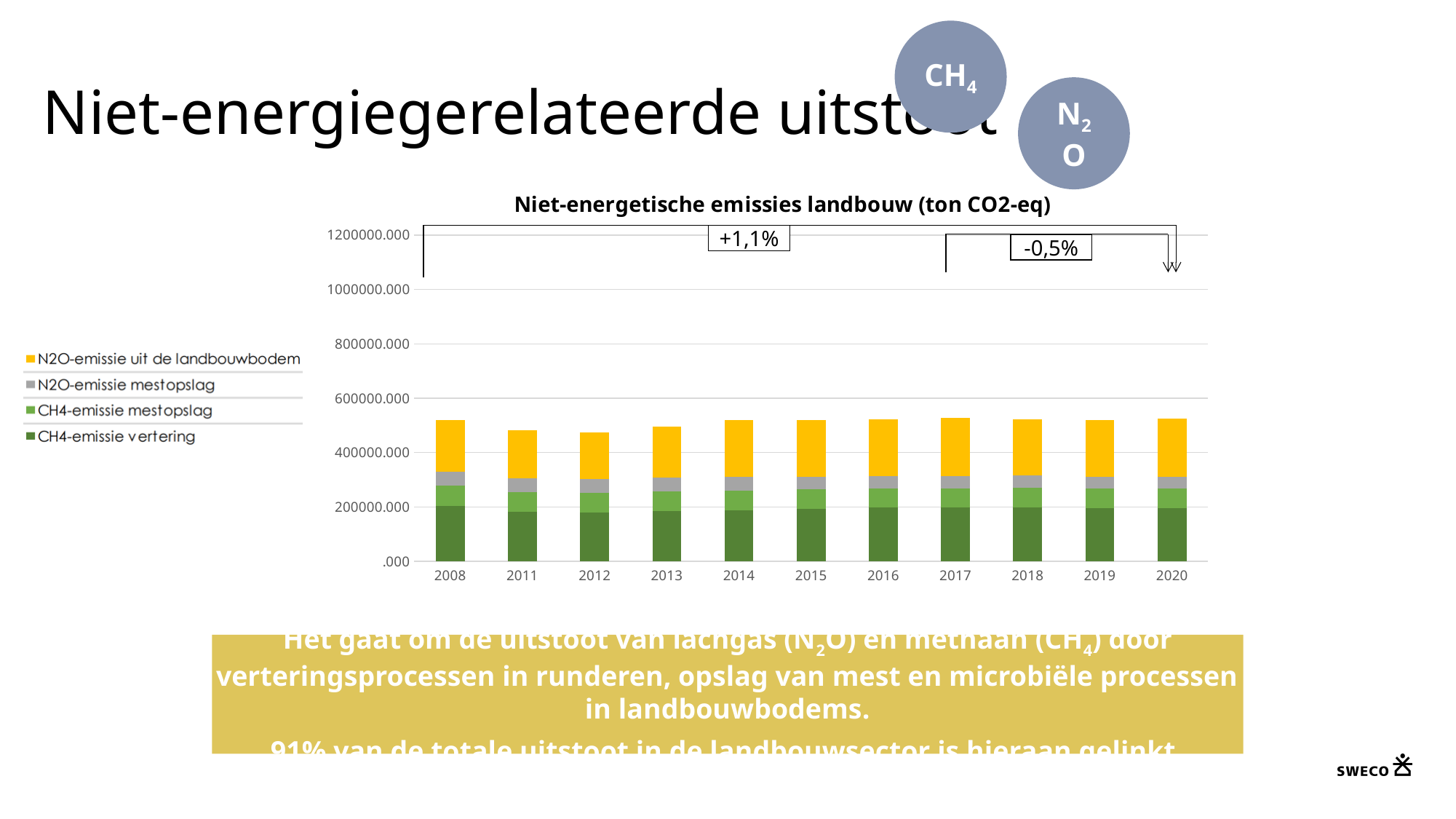
Which series is shown at the bottom of each stacked bar? CH4-emissie vertering Is the total stacked value for 2020 greater or less than 600000.000? less Do the total stacked values rise or fall from 2012 to 2014? rise Is the total stacked value for 2008 greater or less than 400000.000? greater What percentage change is shown in the annotation box on the right side of the chart? -0,5% How many series does the legend list? 4 What is the title of the chart? Niet-energetische emissies landbouw (ton CO2-eq) Is the total stacked value for 2012 greater or less than 600000.000? less How many years are shown on the x axis of the chart? 11 What kind of chart is shown on the slide? stacked bar chart Which year has the larger total stacked value, 2012 or 2014? 2014 Which year has the larger total stacked value, 2008 or 2012? 2008